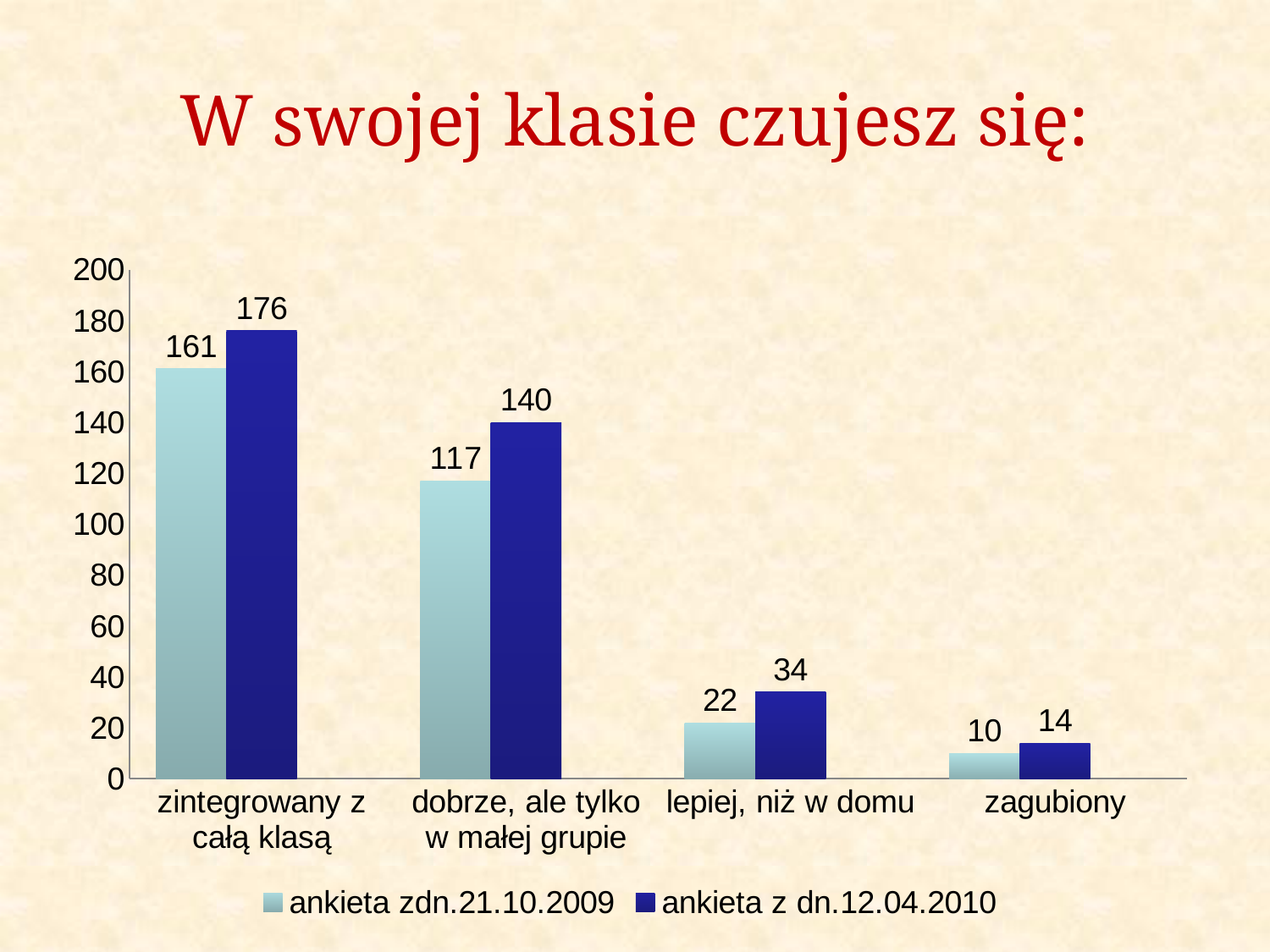
How many categories are shown on the x axis? 4 What is the difference between the 2010 and 2009 values for 'lepiej, niż w domu'? 12 Which category has the lowest value in the 'ankieta z dn.12.04.2010' series? zagubiony Which series has the larger value for 'dobrze, ale tylko w małej grupie'? ankieta z dn.12.04.2010 What is the title of the chart? W swojej klasie czujesz się: What is the value for 'zagubiony' in the 'ankieta z dn.12.04.2010' series? 14 What is the value for 'dobrze, ale tylko w małej grupie' in the 'ankieta zdn.21.10.2009' series? 117 What is the difference between the two series for 'zintegrowany z całą klasą'? 15 What is the value for 'zintegrowany z całą klasą' in the 'ankieta z dn.12.04.2010' series? 176 What kind of chart is shown on the slide? bar chart Which category has the highest value in the 'ankieta zdn.21.10.2009' series? zintegrowany z całą klasą How many series does the legend list? 2